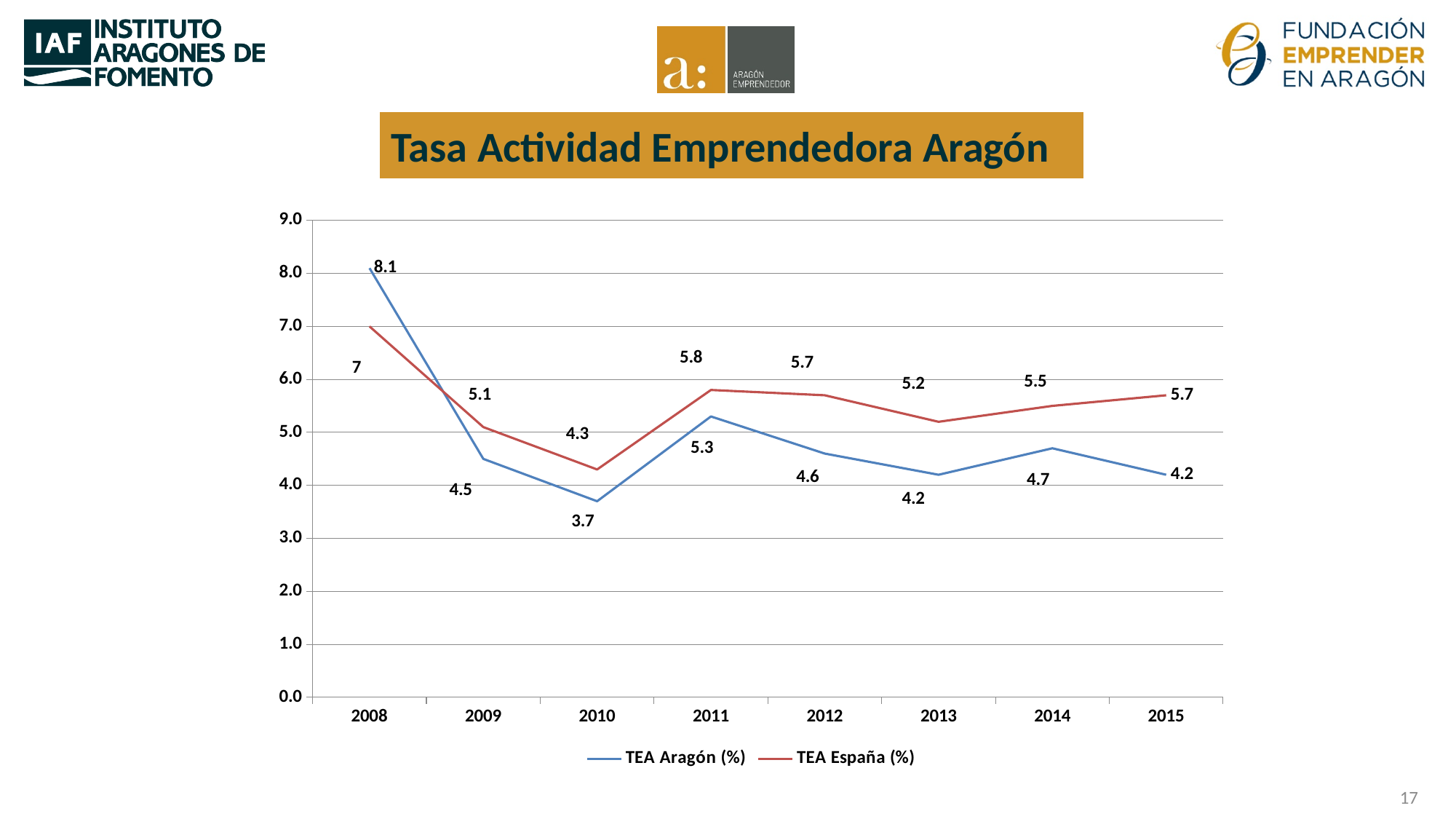
What is the value of TEA España (%) in 2011? 5.8 Does TEA Aragón (%) rise or fall from 2008 to 2010? fall How many series does the legend list? 2 What type of chart is shown on the slide? line chart What is the value of TEA Aragón (%) in 2010? 3.7 In which year is TEA España (%) highest? 2008 In which year is TEA Aragón (%) lowest? 2010 What is the title of the chart? Tasa Actividad Emprendedora Aragón What is the difference between TEA España (%) and TEA Aragón (%) in 2015? 1.5 What is the value of TEA Aragón (%) in 2008? 8.1 How many years are shown on the x axis? 8 Which is larger in 2008, TEA Aragón (%) or TEA España (%)? TEA Aragón (%)